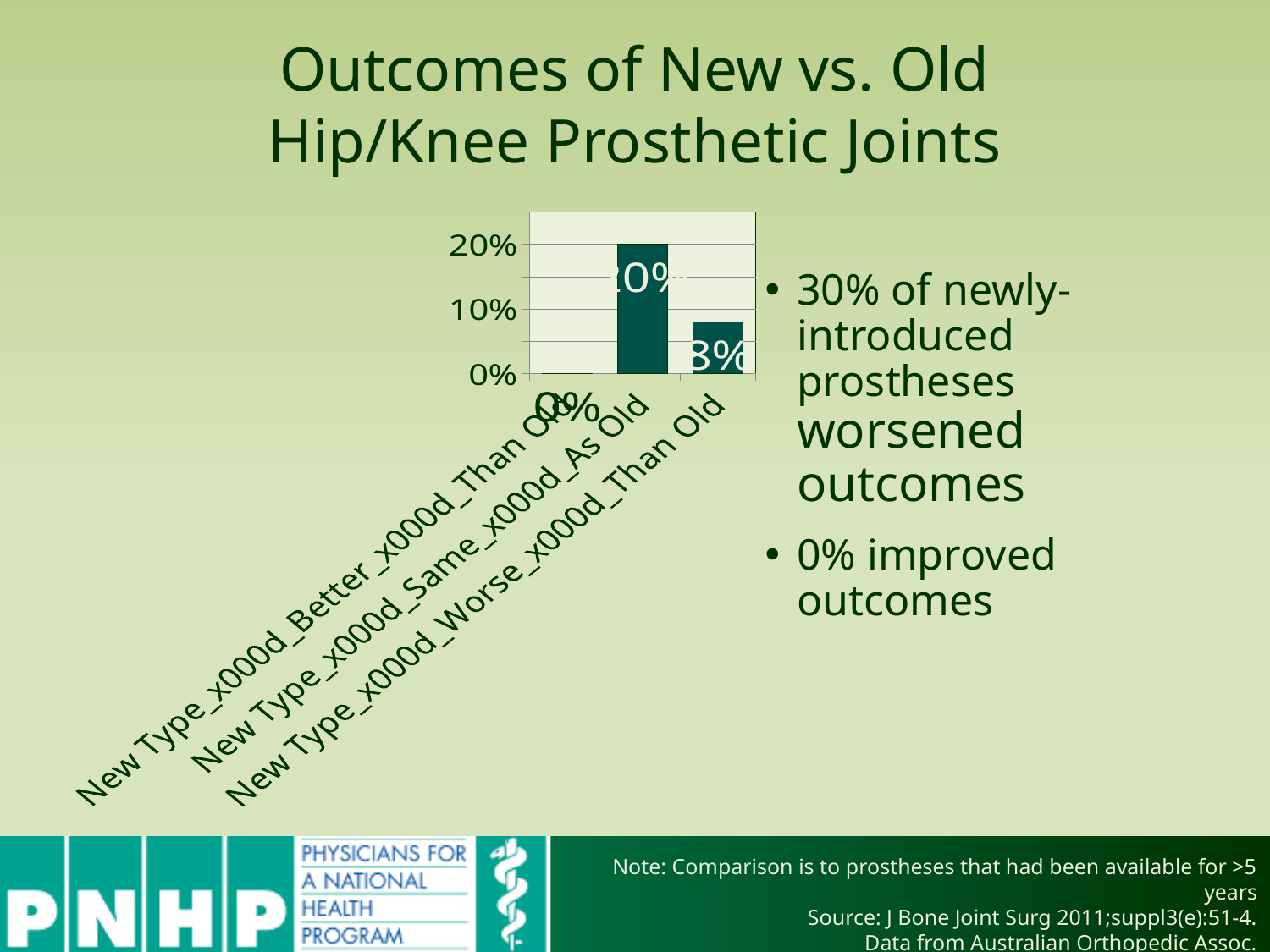
Is the value for 'New Type Same As Old' greater or less than 10%? greater What value is shown for the 'New Type Better Than Old' category? 0% How many bars (categories) does the chart show? 3 Is the value for 'New Type Worse Than Old' greater or less than 0%? greater What is the highest tick label shown on the chart's vertical axis? 20% What kind of chart is shown on the slide? bar chart Which is larger: the value for 'New Type Same As Old' or 'New Type Worse Than Old'? New Type Same As Old Is the value for 'New Type Worse Than Old' greater or less than 10%? less Which category has the lowest value in the chart? New Type Better Than Old Which category has the highest bar in the chart? New Type Same As Old What colour are the bars in the chart? dark green Which is larger: the value for 'New Type Worse Than Old' or 'New Type Better Than Old'? New Type Worse Than Old